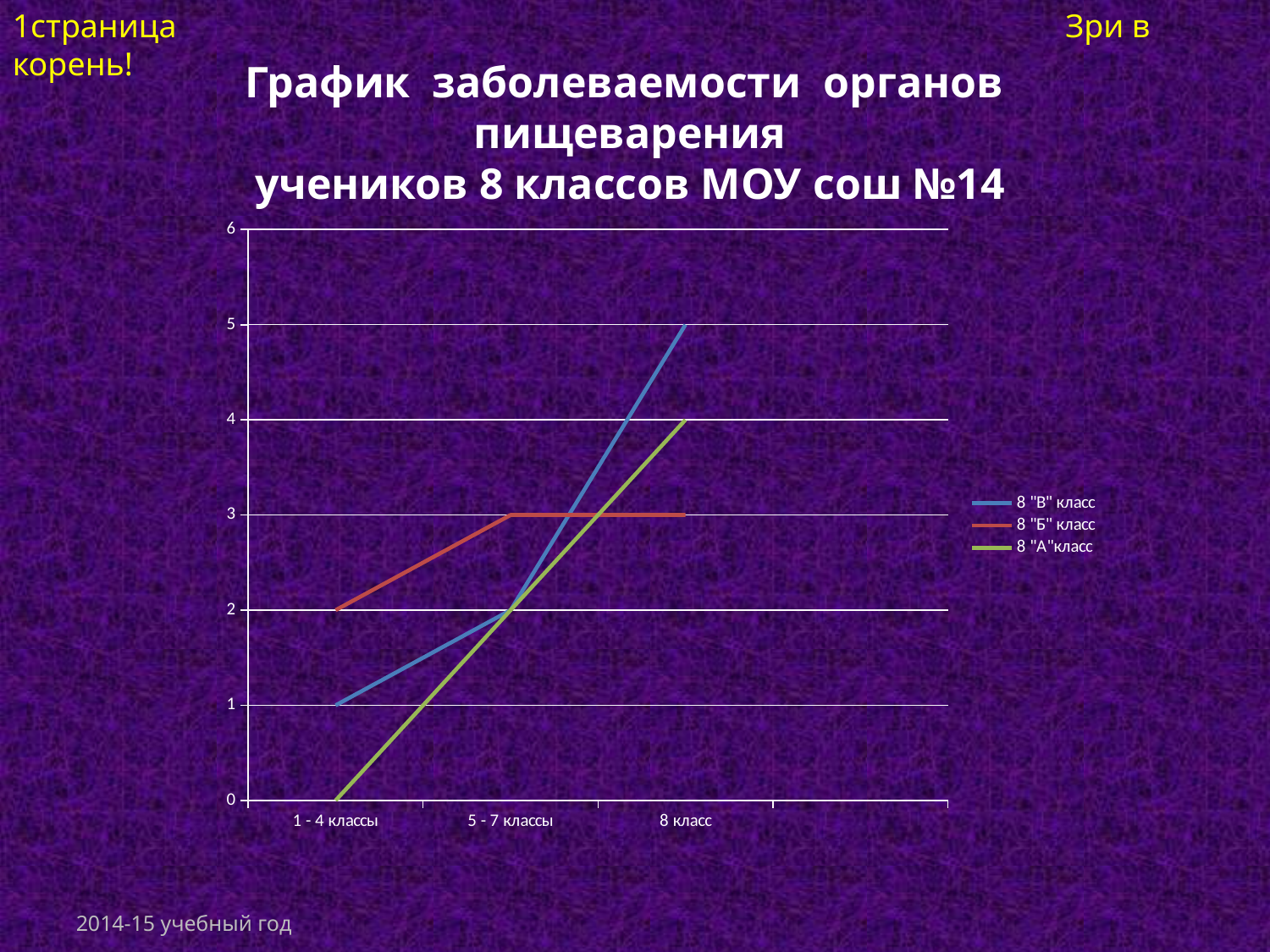
What is the value for 8 "В" класс at 8 класс? 5 What is the value for 8 "Б" класс at 1 - 4 классы? 2 What is the value for 8 "А"класс at 1 - 4 классы? 0 Does the value for 8 "В" класс rise or fall from 1 - 4 классы to 8 класс? rise Which colour is used for the 8 "Б" класс line? red What kind of chart is shown on the slide? line chart Which series has the highest value at 8 класс? 8 "В" класс What is the value for 8 "А"класс at 8 класс? 4 Which series has the lowest value at 1 - 4 классы? 8 "А"класс How many series does the legend list? 3 What is the difference between the values of 8 "В" класс and 8 "Б" класс at 8 класс? 2 How many categories are shown on the x axis? 3